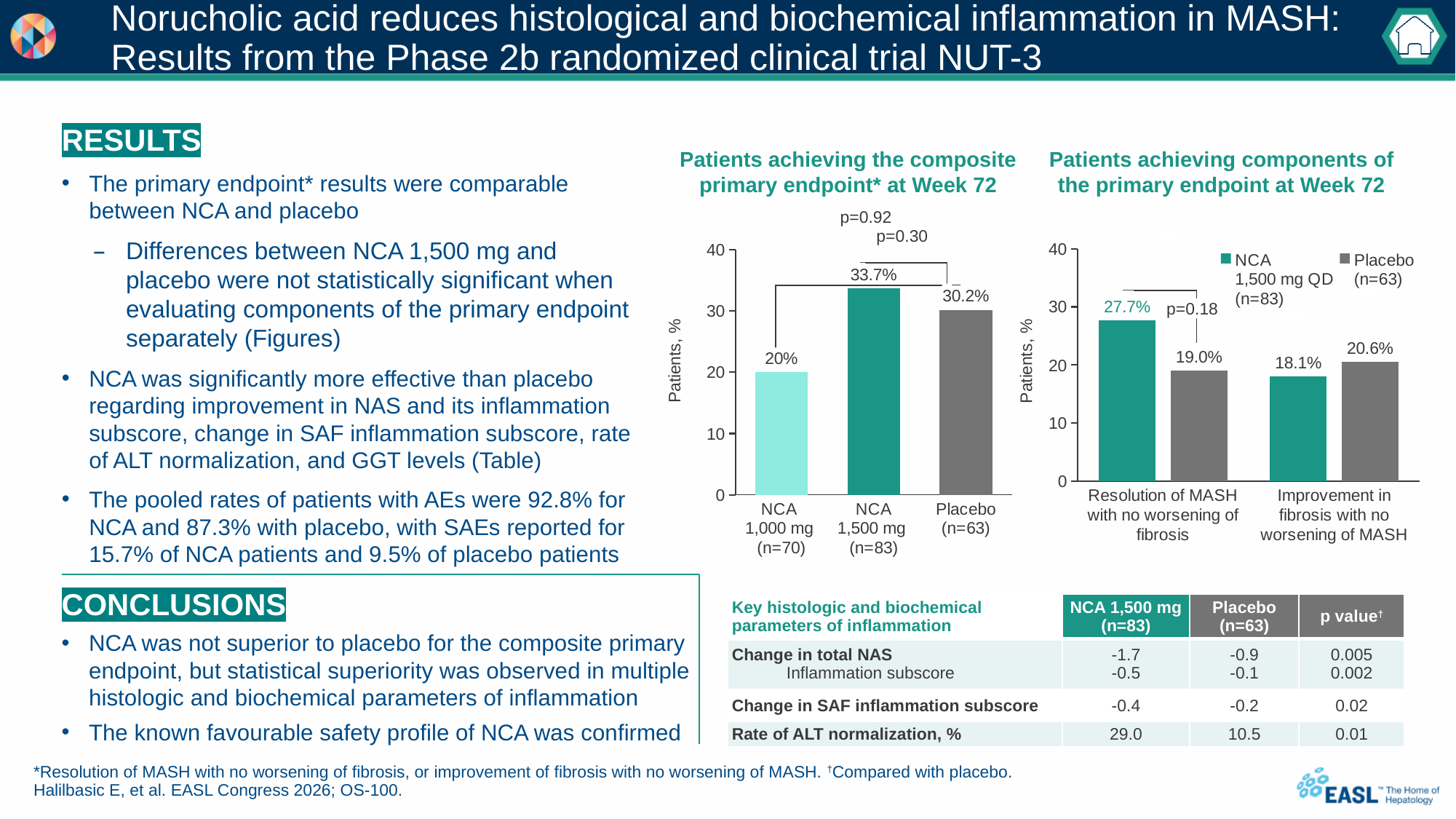
What type of chart is 'Patients achieving components of the primary endpoint at Week 72'? Bar chart In the chart 'Patients achieving components of the primary endpoint at Week 72', which is larger for resolution of MASH with no worsening of fibrosis: NCA 1,500 mg QD or Placebo? NCA 1,500 mg QD In the chart 'Patients achieving components of the primary endpoint at Week 72', what is the Placebo value for improvement in fibrosis with no worsening of MASH? 20.6% How many series does the legend list in the chart 'Patients achieving components of the primary endpoint at Week 72'? 2 In the chart 'Patients achieving the composite primary endpoint* at Week 72', what is the value for Placebo (n=63)? 30.2% In the chart 'Patients achieving the composite primary endpoint* at Week 72', what percentage of patients in the NCA 1,500 mg (n=83) group achieved the endpoint? 33.7% In the chart 'Patients achieving components of the primary endpoint at Week 72', what is the difference between the NCA 1,500 mg QD and Placebo values for resolution of MASH with no worsening of fibrosis? 8.7% In the chart 'Patients achieving components of the primary endpoint at Week 72', what percentage of NCA 1,500 mg QD patients achieved resolution of MASH with no worsening of fibrosis? 27.7% In the chart 'Patients achieving the composite primary endpoint* at Week 72', which group has the lowest percentage of patients? NCA 1,000 mg (n=70) In the chart 'Patients achieving the composite primary endpoint* at Week 72', what is the difference between the NCA 1,500 mg and Placebo values? 3.5% In the chart 'Patients achieving the composite primary endpoint* at Week 72', which group has the highest percentage of patients? NCA 1,500 mg (n=83) How many bars are shown in the chart 'Patients achieving the composite primary endpoint* at Week 72'? 3